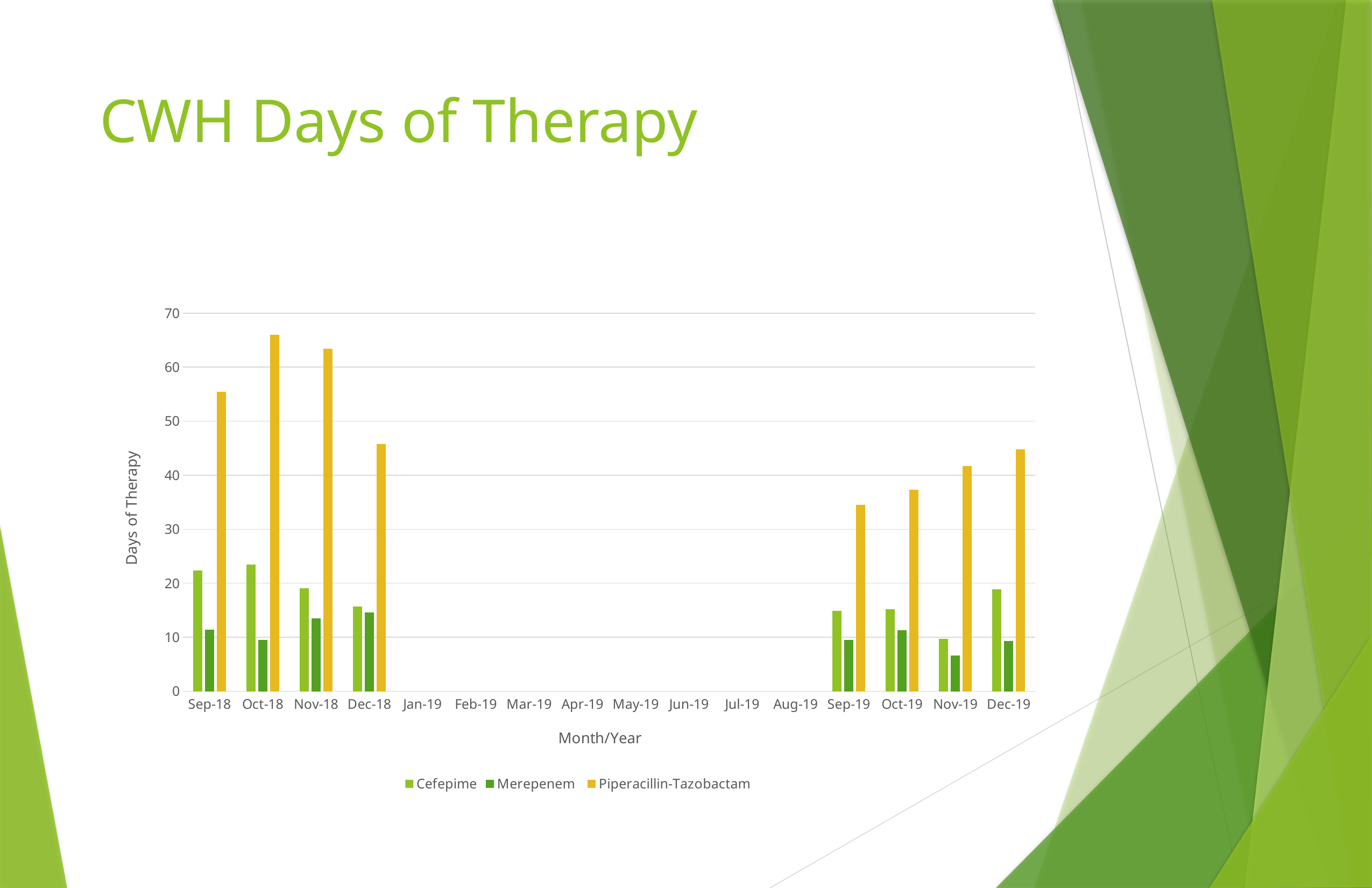
In which month is the Piperacillin-Tazobactam value highest? Oct-18 In which month is the Merepenem value lowest? Nov-19 Is the Piperacillin-Tazobactam value for Oct-18 greater or less than 60? greater In Sep-18, which is larger: the Cefepime value or the Merepenem value? Cefepime Is the Piperacillin-Tazobactam value for Sep-19 greater or less than 40? less Do the Piperacillin-Tazobactam values rise or fall from Sep-19 to Dec-19? rise What kind of chart is shown on the slide? bar chart How many series does the legend list? 3 What is the label of the y axis? Days of Therapy In which month is the Piperacillin-Tazobactam value lowest? Sep-19 How many month labels are shown on the x axis? 16